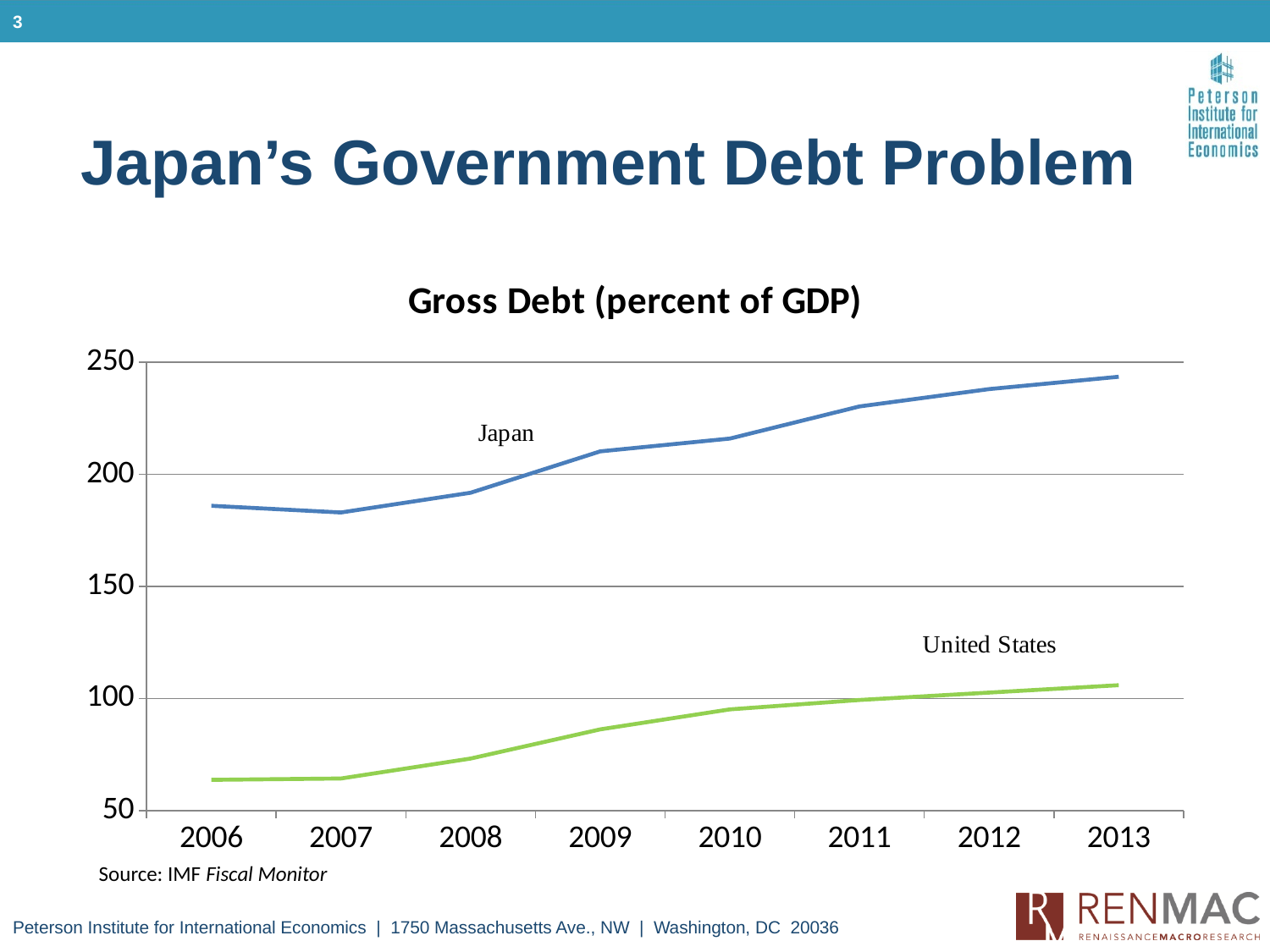
Is the value for the United States in 2006 greater or less than 100? less What is the title of the chart? Gross Debt (percent of GDP) Is the value for Japan in 2013 greater or less than 200? greater What is the source cited below the chart? IMF Fiscal Monitor How many series are plotted in the chart? 2 What kind of chart is shown on the slide? line chart Is the value for the United States in 2013 greater or less than 100? greater Does the United States line rise or fall from 2006 to 2013? rise How many years are shown along the x axis of the chart? 8 Which series has the higher value in 2013, Japan or the United States? Japan